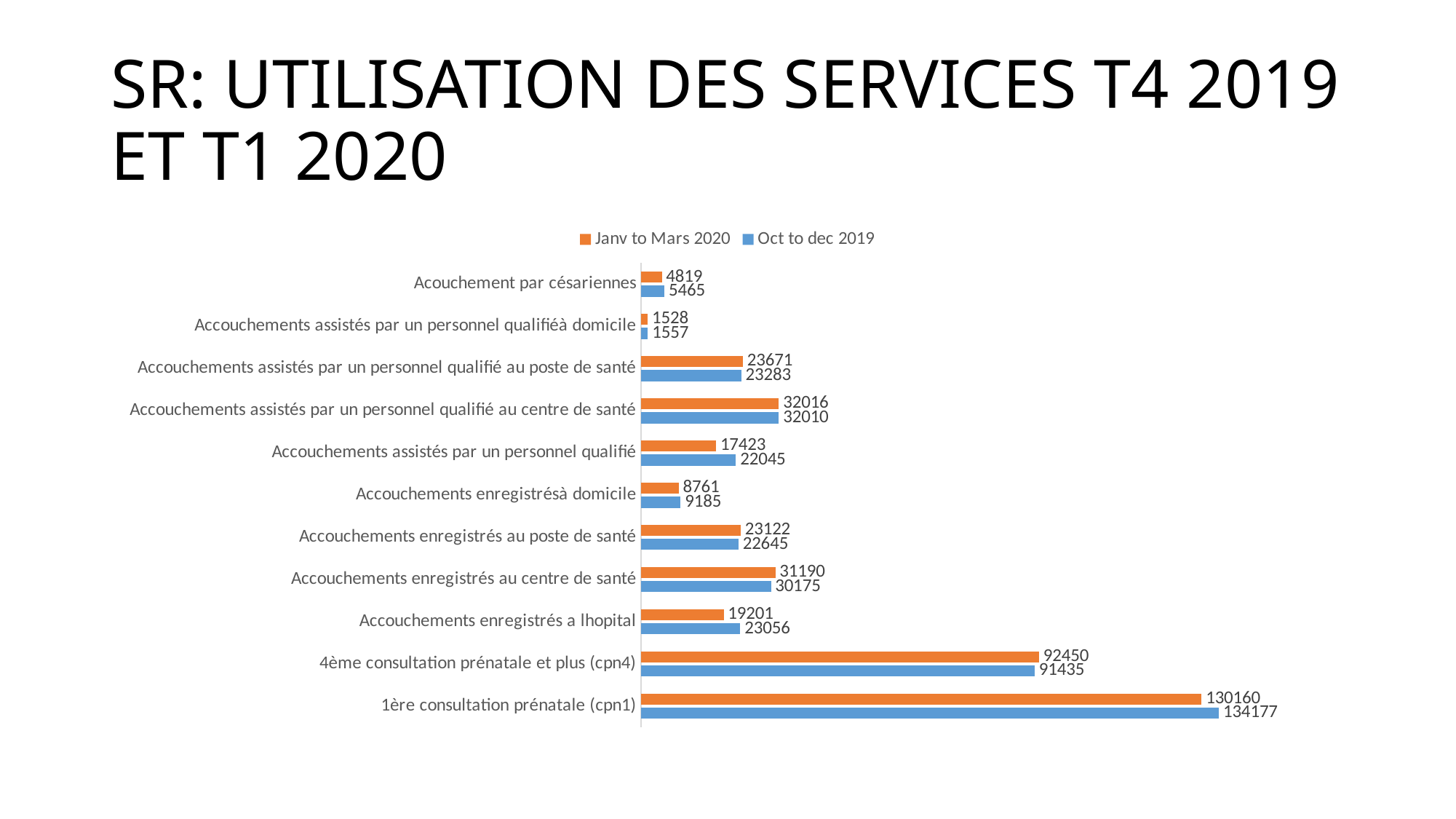
Which colour represents the Janv to Mars 2020 series? Orange Which category has the lowest value in the Janv to Mars 2020 series? Accouchements assistés par un personnel qualifiéà domicile What is the difference between the Oct to dec 2019 and Janv to Mars 2020 values for "Accouchements assistés par un personnel qualifié"? 4622 What kind of chart is shown on the slide? Bar chart What is the value for "Acouchement par césariennes" in the Janv to Mars 2020 series? 4819 What is the value for "Accouchements enregistrés a lhopital" in the Janv to Mars 2020 series? 19201 Which category has the highest value in the Oct to dec 2019 series? 1ère consultation prénatale (cpn1) For "Accouchements enregistrés au centre de santé", which series has the larger value? Janv to Mars 2020 How many categories are shown on the chart? 11 How many series does the legend list? 2 What is the difference between the Oct to dec 2019 and Janv to Mars 2020 values for "1ère consultation prénatale (cpn1)"? 4017 What is the value for "1ère consultation prénatale (cpn1)" in the Oct to dec 2019 series? 134177